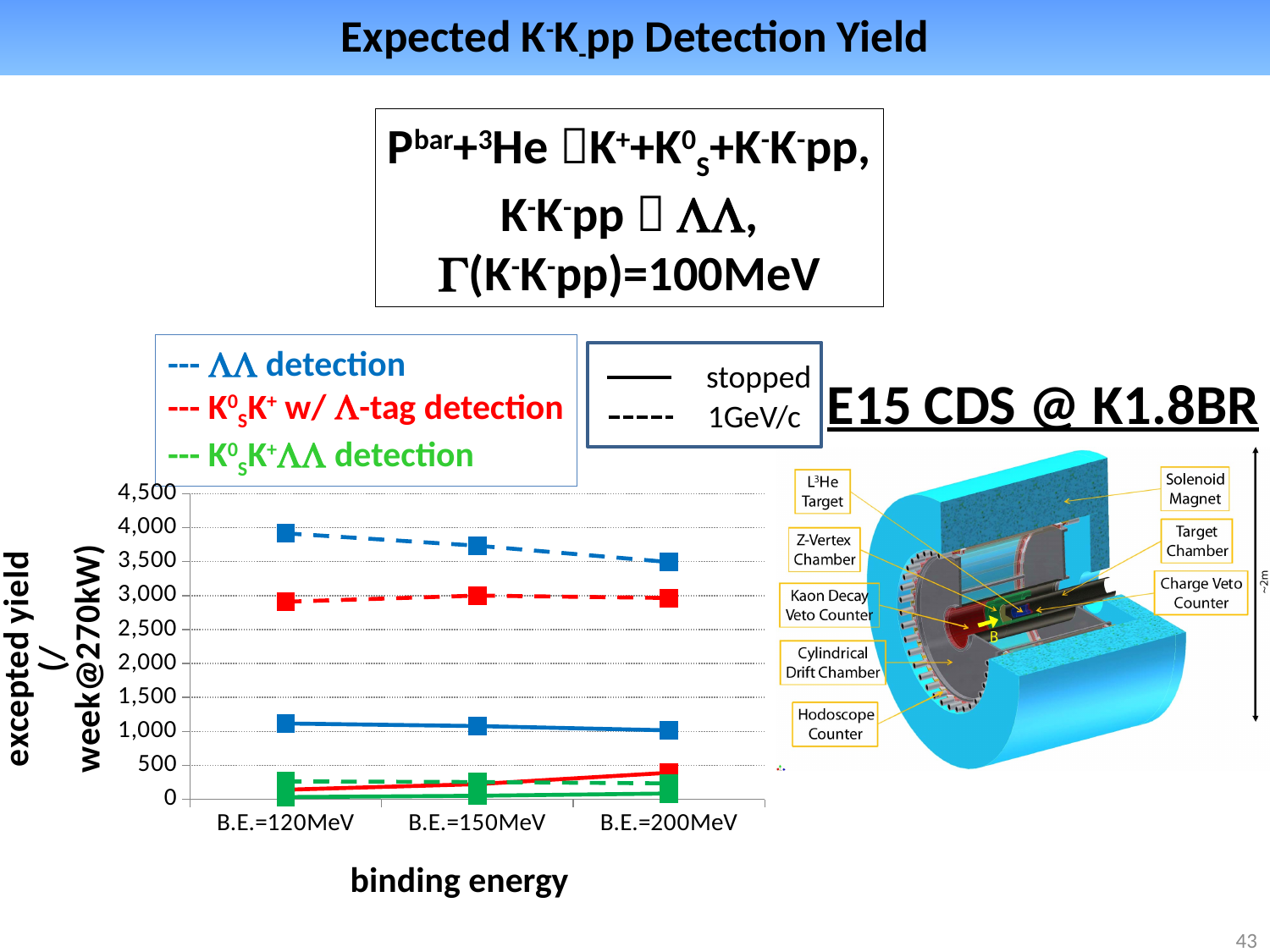
How many binding energy categories are plotted on the x axis? 3 Is the value of the dashed blue (ΛΛ detection, 1GeV/c) line at B.E.=120MeV greater or less than 3,500? greater Is the value of the solid blue (ΛΛ detection, stopped) line at B.E.=120MeV greater or less than 1,000? greater Is the value of the solid green (K0sK+ΛΛ detection, stopped) line at B.E.=120MeV greater or less than 500? less What is the label of the x axis of the chart? binding energy How many detection modes does the legend list? 3 Does the solid red (K0sK+ w/ Λ-tag detection, stopped) line rise or fall from B.E.=120MeV to B.E.=200MeV? rise Which line has the highest value at B.E.=120MeV? dashed blue (ΛΛ detection, 1GeV/c) At B.E.=120MeV, which is larger: the dashed blue (ΛΛ detection) line or the dashed red (K0sK+ w/ Λ-tag detection) line? dashed blue (ΛΛ detection) Does the dashed blue (ΛΛ detection, 1GeV/c) line rise or fall as binding energy increases from 120MeV to 200MeV? fall What kind of chart is shown on the slide? line chart